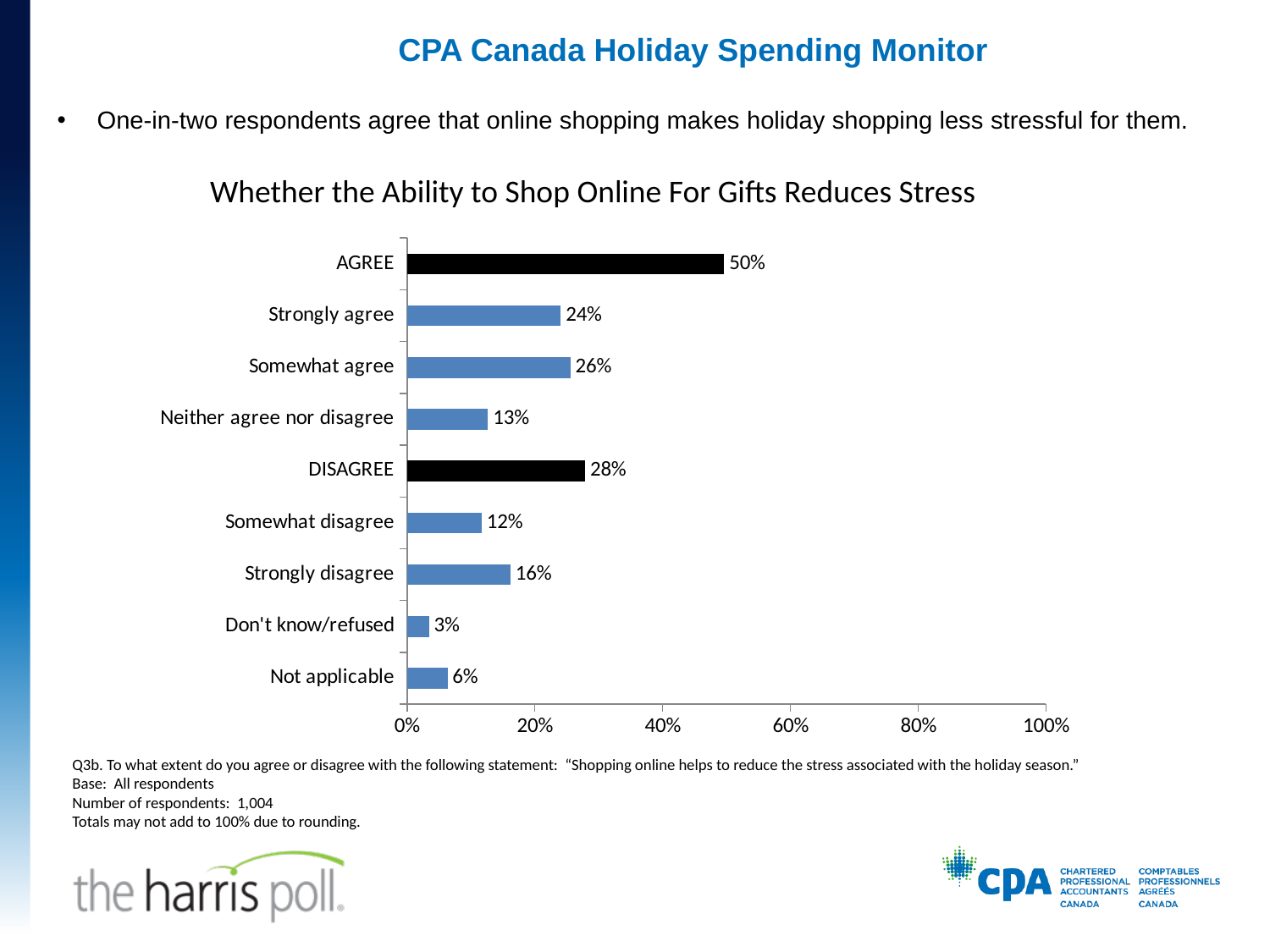
What is the title of the chart? Whether the Ability to Shop Online For Gifts Reduces Stress What kind of chart is shown on the slide? Bar chart What is the difference between AGREE and DISAGREE? 22% What is the difference between Strongly disagree and Somewhat disagree? 4% Which category has the highest value? AGREE How many categories are shown on the chart? 9 What is the value for Strongly agree? 24% Which category has the lowest value? Don't know/refused What is the value for Neither agree nor disagree? 13% What is the value for AGREE? 50% Which is larger, Somewhat agree or Strongly agree? Somewhat agree What is the value for Not applicable? 6%